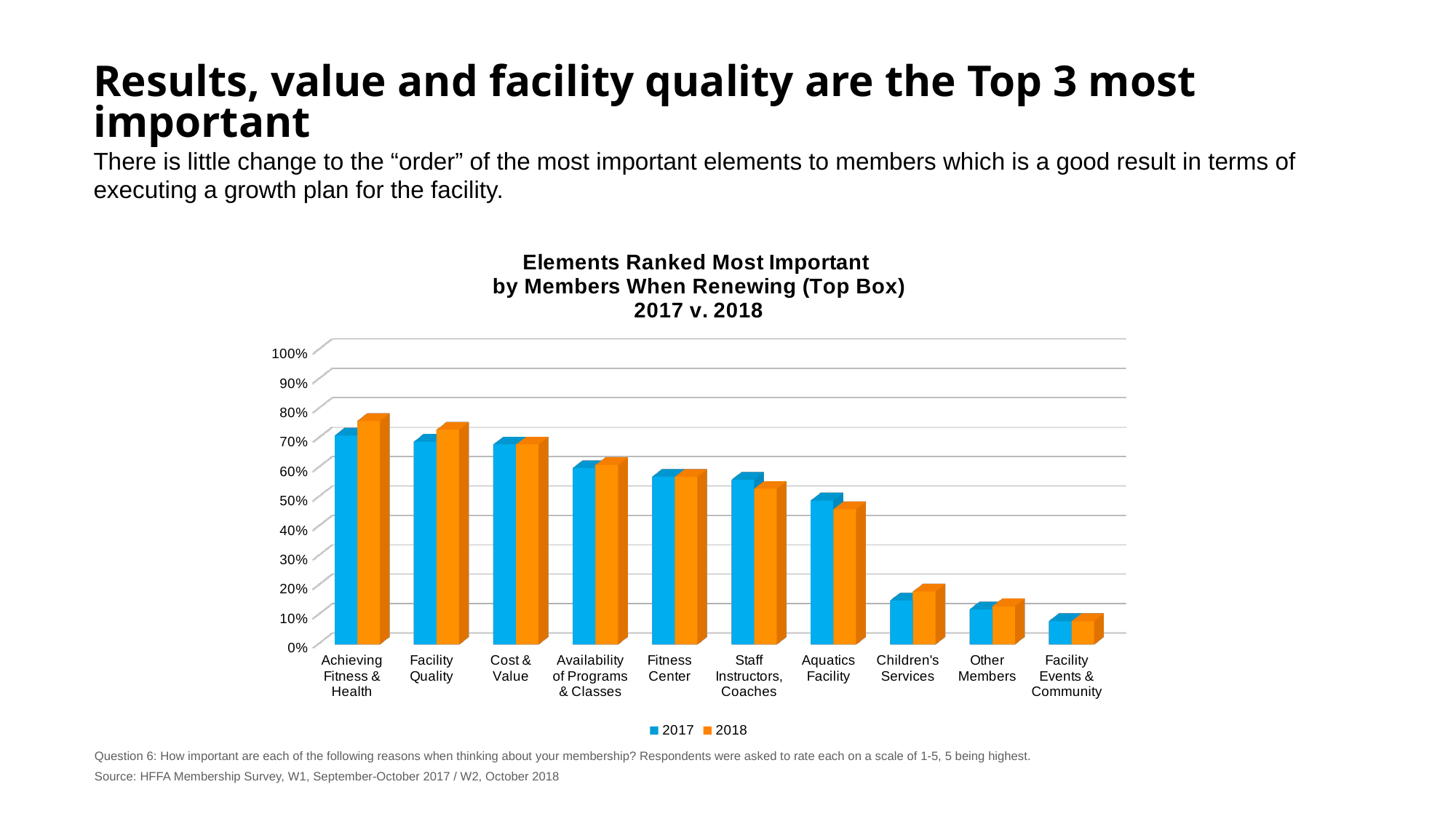
What kind of chart is shown on the slide? Bar chart Is the 2017 value for Aquatics Facility greater or less than 60%? less Is the 2018 value for Other Members greater or less than 20%? less Which category has the highest value for 2018? Achieving Fitness & Health Which is larger for 2017: Aquatics Facility or Children's Services? Aquatics Facility Which category has the lowest value for 2017? Facility Events & Community Is the 2018 value for Achieving Fitness & Health greater or less than 70%? greater How many categories are shown on the x axis? 10 How many series does the legend list? 2 For Achieving Fitness & Health, which year has the larger value, 2017 or 2018? 2018 Do the 2017 values generally rise or fall moving from left to right along the x axis? Fall